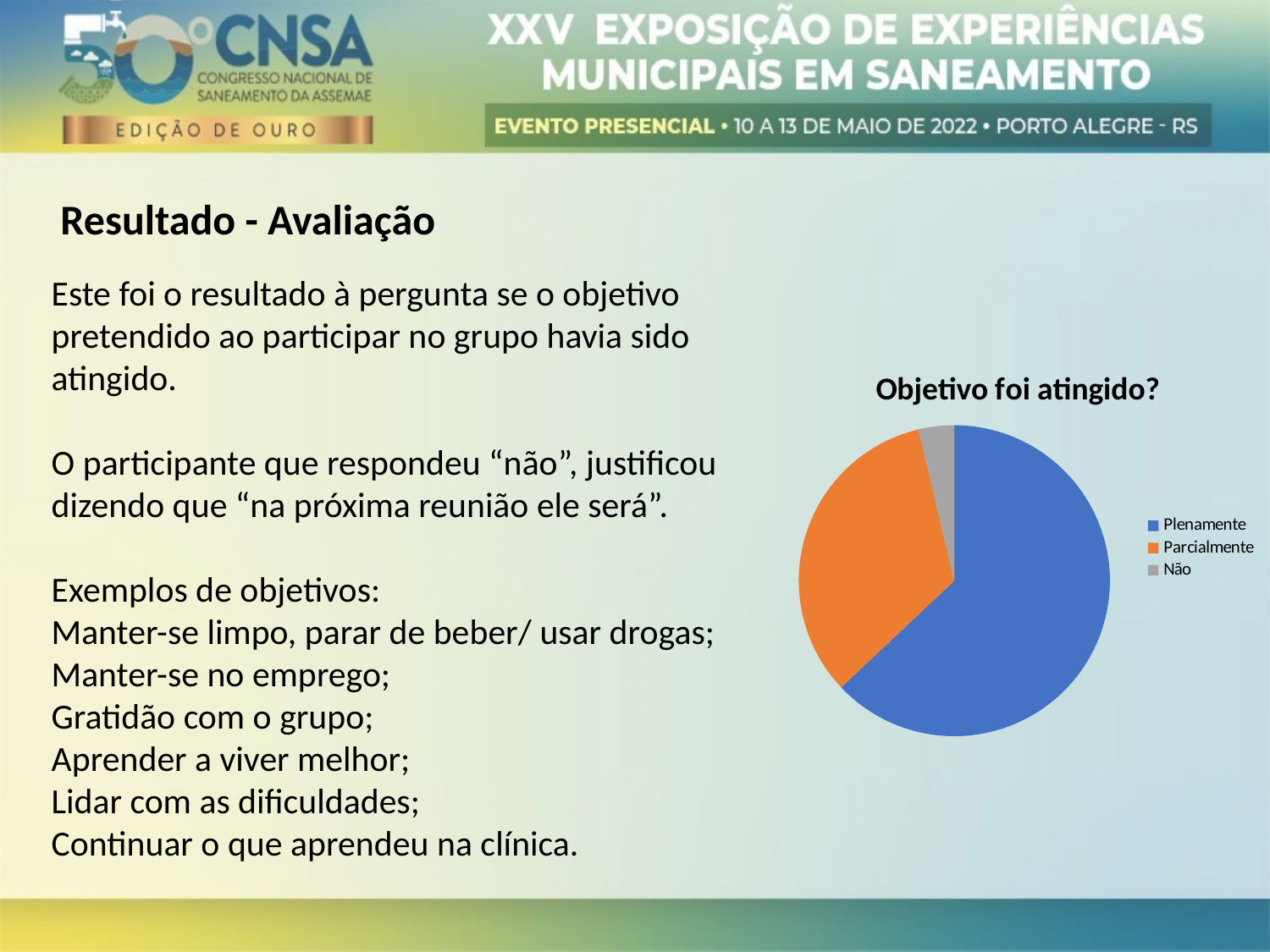
Which slice is larger, Parcialmente or Não? Parcialmente Does the Plenamente slice account for more or less than half of the pie? more Which category has the largest slice of the pie? Plenamente Which slice is larger, Plenamente or Parcialmente? Plenamente What kind of chart is shown on the slide? pie chart What colour is the slice for Parcialmente? orange Which category has the smallest slice of the pie? Não What is the title of the chart? Objetivo foi atingido? How many categories does the pie chart's legend list? 3